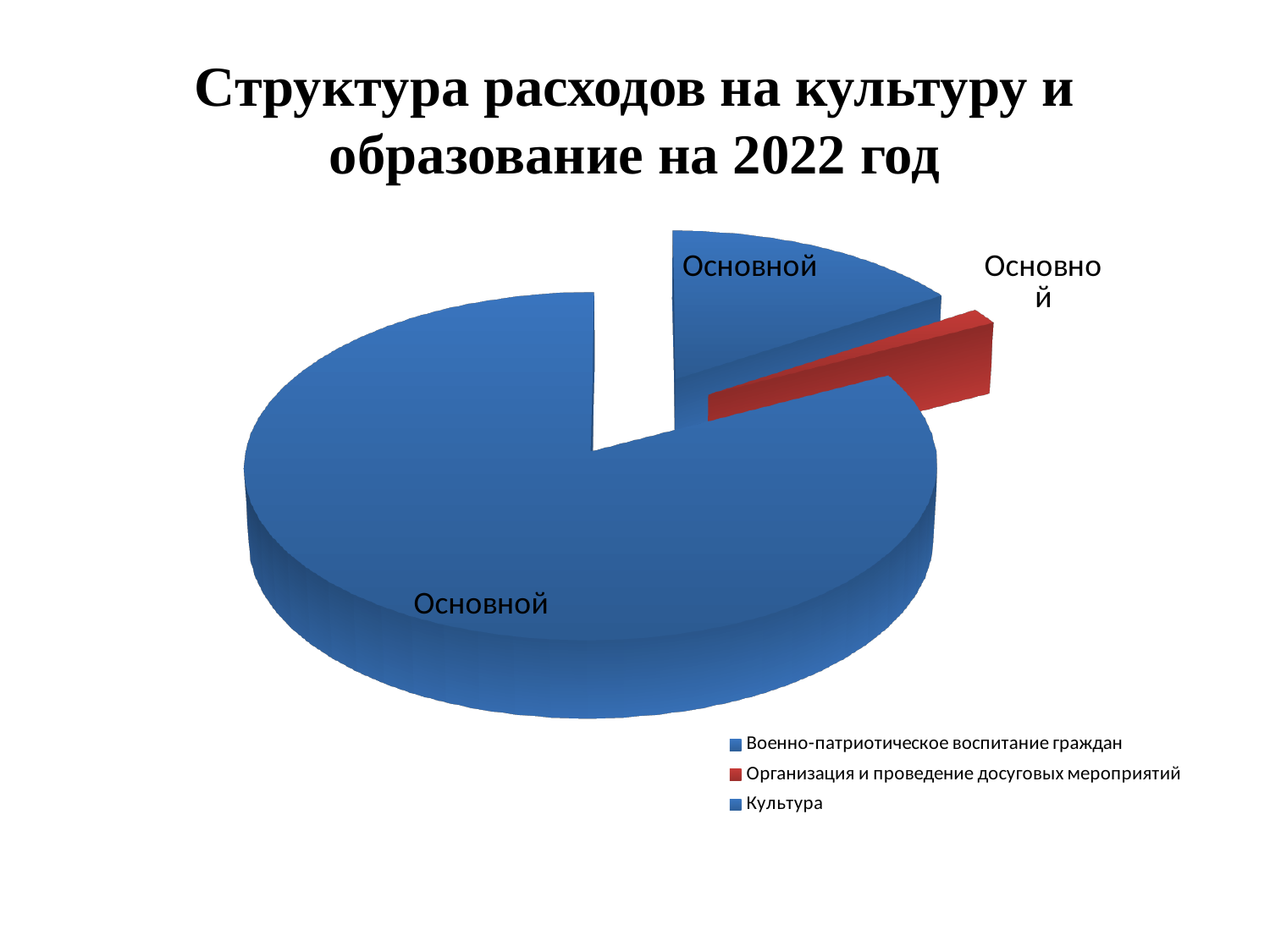
What colour is the slice for Организация и проведение досуговых мероприятий? red How many entries does the legend list? 3 Which slice is larger: Организация и проведение досуговых мероприятий or Культура? Культура What kind of chart is shown on the slide? pie chart How many slices does the pie chart have? 3 Which category has the largest slice of the pie? Культура Which category has the smallest slice of the pie? Организация и проведение досуговых мероприятий What is the title of the slide? Структура расходов на культуру и образование на 2022 год